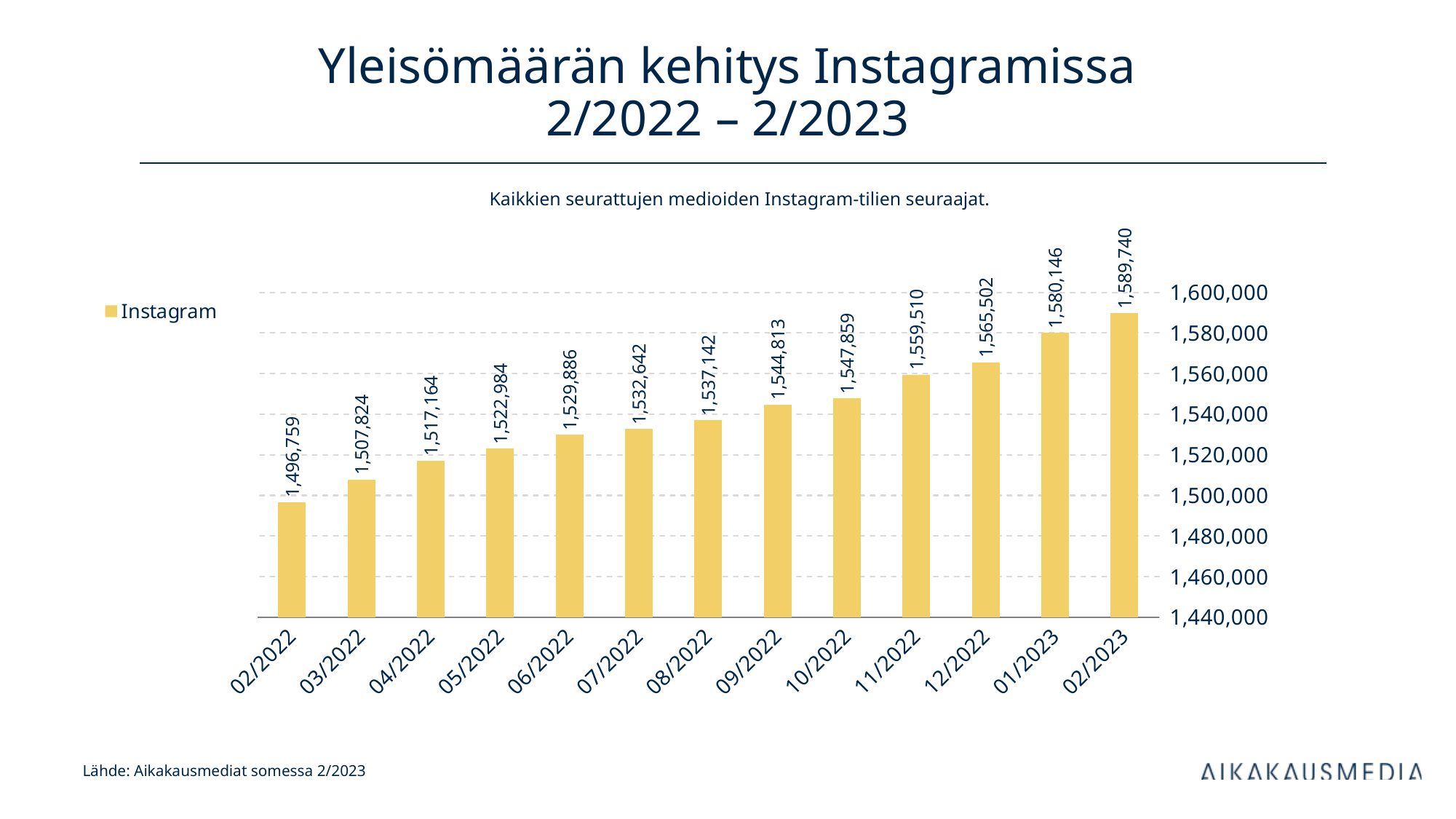
What is the value for 02/2022? 1,496,759 What is the value for 09/2022? 1,544,813 What is the difference between the values for 01/2023 and 12/2022? 14,644 Is the value for 11/2022 greater or less than 1,540,000? greater Which is larger, the value for 06/2022 or the value for 08/2022? 08/2022 Do the values rise or fall from 02/2022 to 02/2023? rise Which month has the highest value? 02/2023 What kind of chart is shown? bar chart How many months are shown on the x axis? 13 What is the difference between the values for 02/2023 and 02/2022? 92,981 What is the value for 02/2023? 1,589,740 Which month has the lowest value? 02/2022